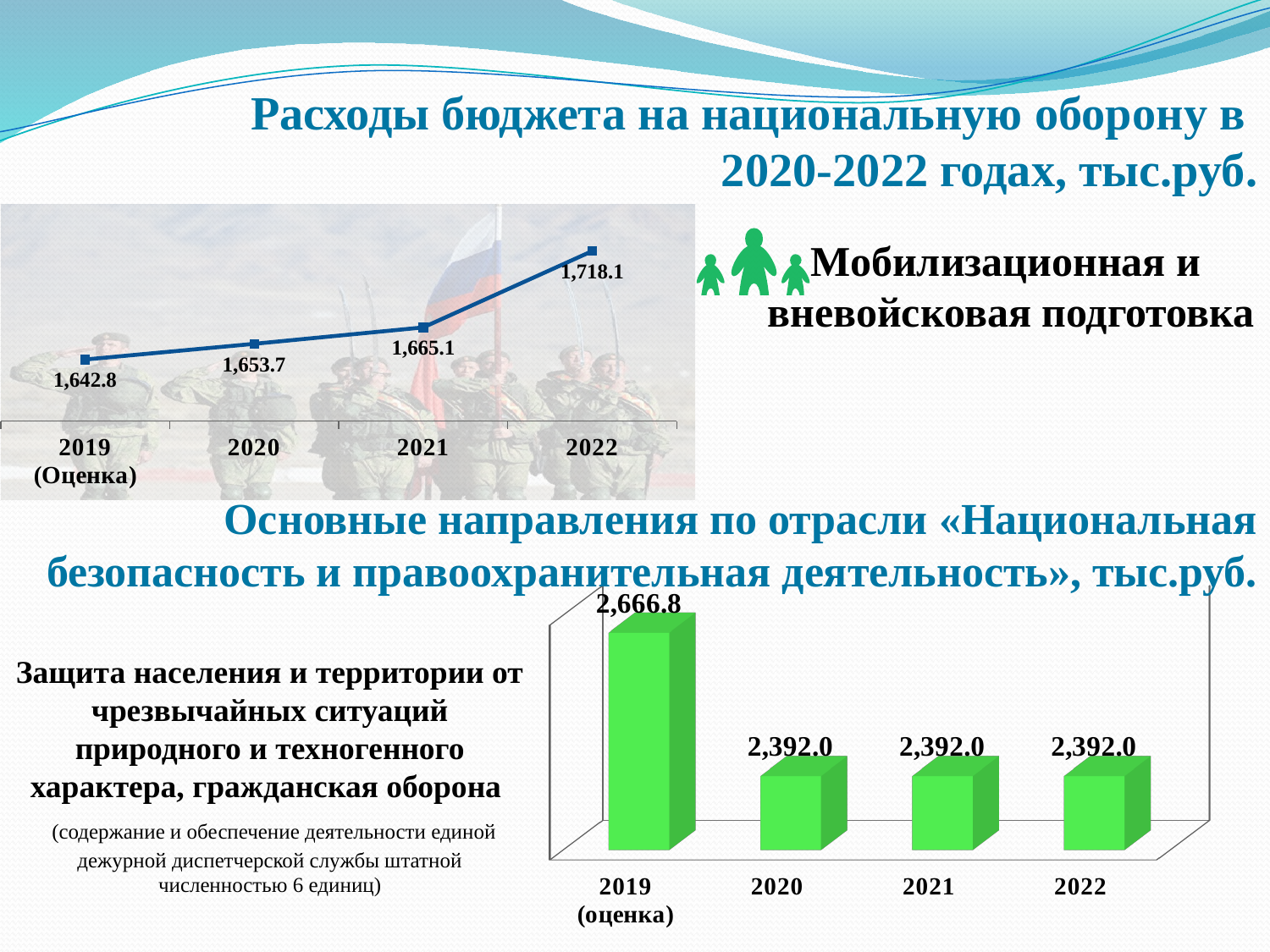
How many bars are shown in the bottom bar chart on national security and law enforcement? 4 In the top line chart on national defence expenditure, what is the value for 2020? 1,653.7 In the top line chart on national defence expenditure, do the values rise or fall from 2019 to 2022? rise What kind of chart is the top chart on national defence expenditure? line chart In the top line chart on national defence expenditure, what is the difference between the 2022 value and the 2021 value? 53.0 In the top line chart on national defence expenditure, what is the value for 2022? 1,718.1 In the bottom bar chart on national security and law enforcement, what is the value for 2019 (оценка)? 2,666.8 In the top line chart on national defence expenditure, what is the value for 2019 (Оценка)? 1,642.8 In the bottom bar chart on national security and law enforcement, what is the difference between the 2019 (оценка) value and the 2020 value? 274.8 In the top line chart on national defence expenditure, which year has the lowest value? 2019 (Оценка) In the top line chart on national defence expenditure, which year has the highest value? 2022 In the bottom bar chart on national security and law enforcement, what is the value for 2021? 2,392.0